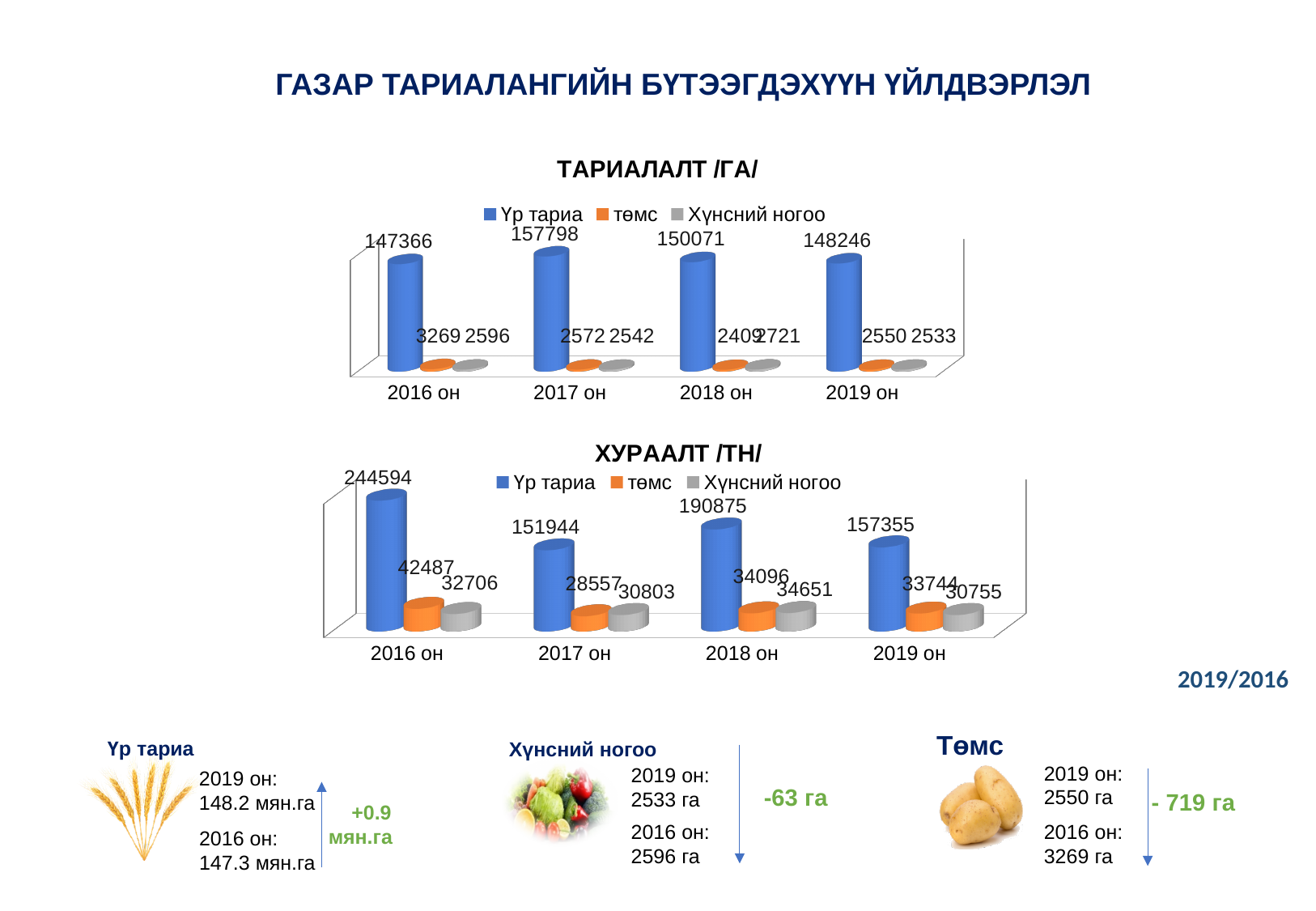
In the ХУРААЛТ /ТН/ chart, what is the value for Хүнсний ногоо in 2018 он? 34651 How many years are shown on the x axis of the ХУРААЛТ /ТН/ chart? 4 In the ХУРААЛТ /ТН/ chart, what is the value for Үр тариа in 2016 он? 244594 In the ТАРИАЛАЛТ /ГА/ chart, what is the difference between the Үр тариа values for 2017 он and 2016 он? 10432 In the ТАРИАЛАЛТ /ГА/ chart, what is the value for Үр тариа in 2017 он? 157798 What type of chart is the ТАРИАЛАЛТ /ГА/ chart? Bar chart In the ТАРИАЛАЛТ /ГА/ chart, how many series does the legend list? 3 In the ТАРИАЛАЛТ /ГА/ chart, what is the value for төмс in 2016 он? 3269 In the ХУРААЛТ /ТН/ chart, which year has the lowest value for Үр тариа? 2017 он In the ХУРААЛТ /ТН/ chart, what is the difference between the төмс values for 2016 он and 2019 он? 8743 In the ХУРААЛТ /ТН/ chart, which is larger: төмс in 2016 он or төмс in 2018 он? төмс in 2016 он In the ТАРИАЛАЛТ /ГА/ chart, which year has the highest value for Үр тариа? 2017 он